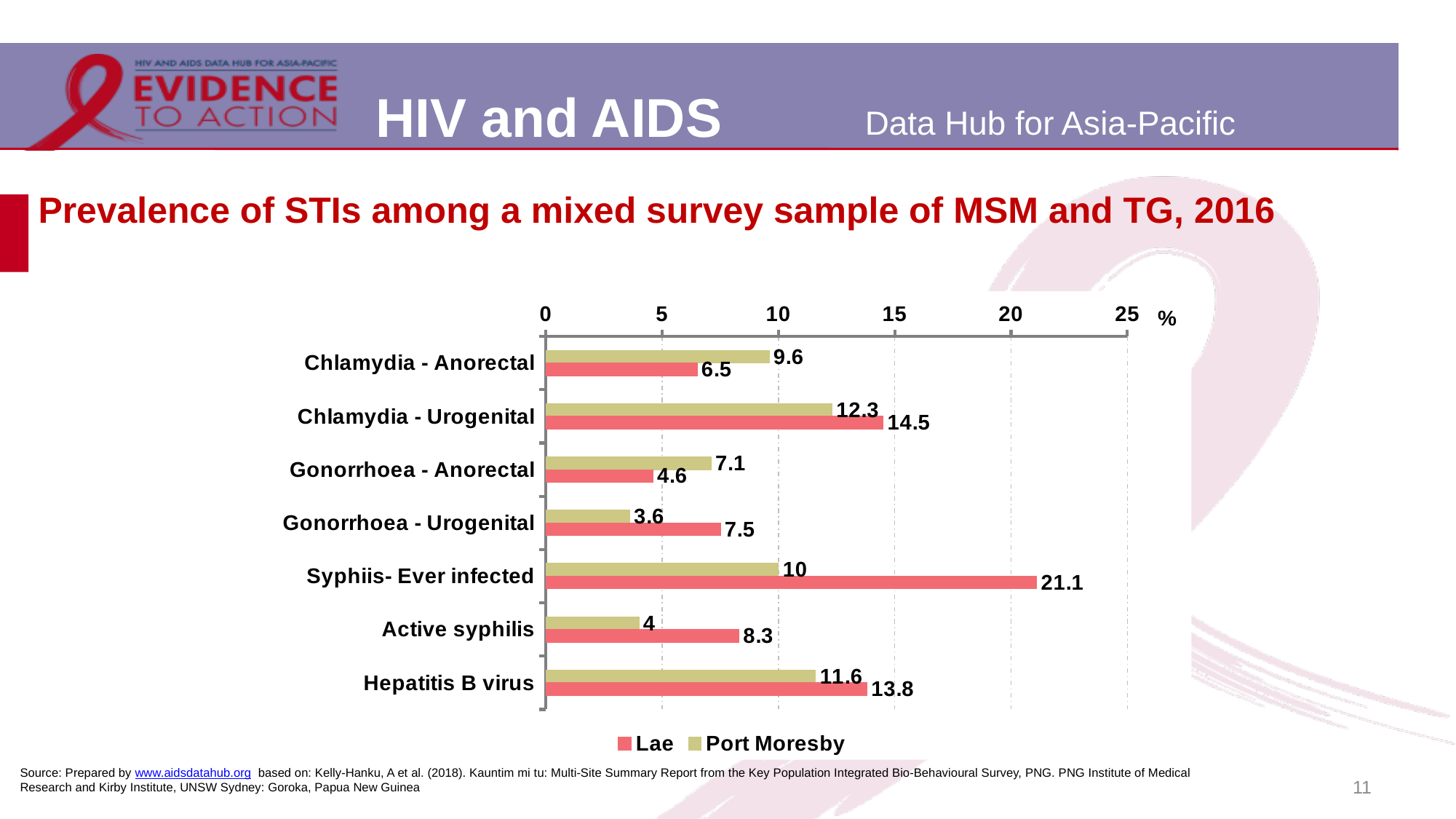
Which category has the highest Lae value? Syphiis- Ever infected What kind of chart is shown on the slide? Bar chart How many series does the legend list? 2 What is the difference between the Lae and Port Moresby values for Active syphilis? 4.3 Which category has the lowest Port Moresby value? Gonorrhoea - Urogenital How many categories are shown on the chart? 7 What is the Lae value for Syphiis- Ever infected? 21.1 Is the Lae value for Syphiis- Ever infected greater or less than 20? greater For Chlamydia - Anorectal, which is larger, the Lae value or the Port Moresby value? Port Moresby Which series is shown in red? Lae What is the Port Moresby value for Chlamydia - Urogenital? 12.3 What is the Lae value for Hepatitis B virus? 13.8